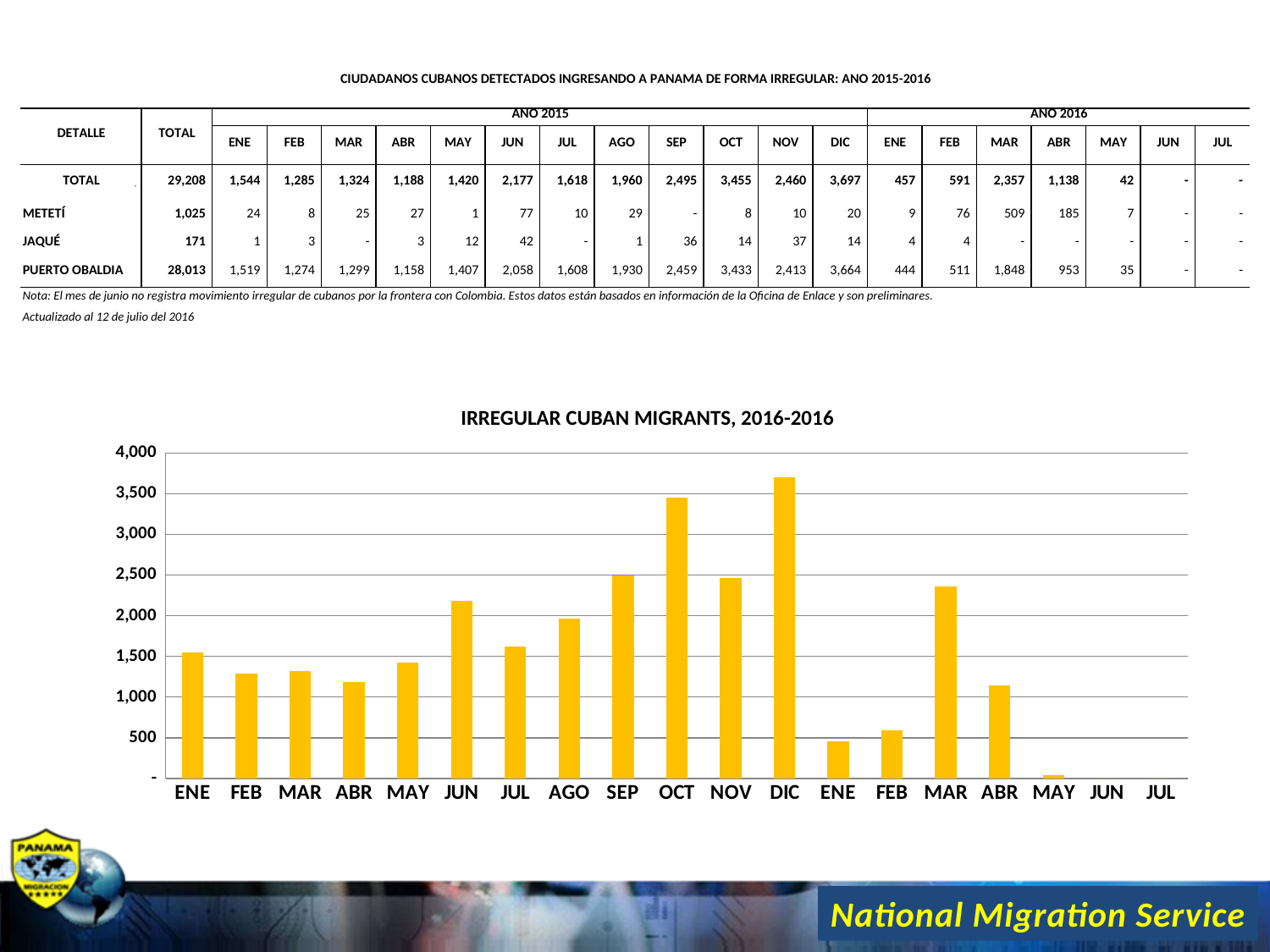
Which month has the highest bar in the chart? DIC (2015) Which is larger in the chart, the OCT 2015 bar or the NOV 2015 bar? OCT 2015 What kind of chart is shown on the slide? bar chart Is the value for the first FEB bar (2015) greater or less than 1,500? less Is the value for the second MAR bar (2016) greater or less than 2,000? greater What colour are the bars in the chart? yellow What is the title of the chart? IRREGULAR CUBAN MIGRANTS, 2016-2016 Is the value for the first DIC bar (2015) greater or less than 3,500? greater How many month categories are shown along the x axis of the chart? 19 Do the values rise or fall from JUL 2015 to OCT 2015 in the chart? rise